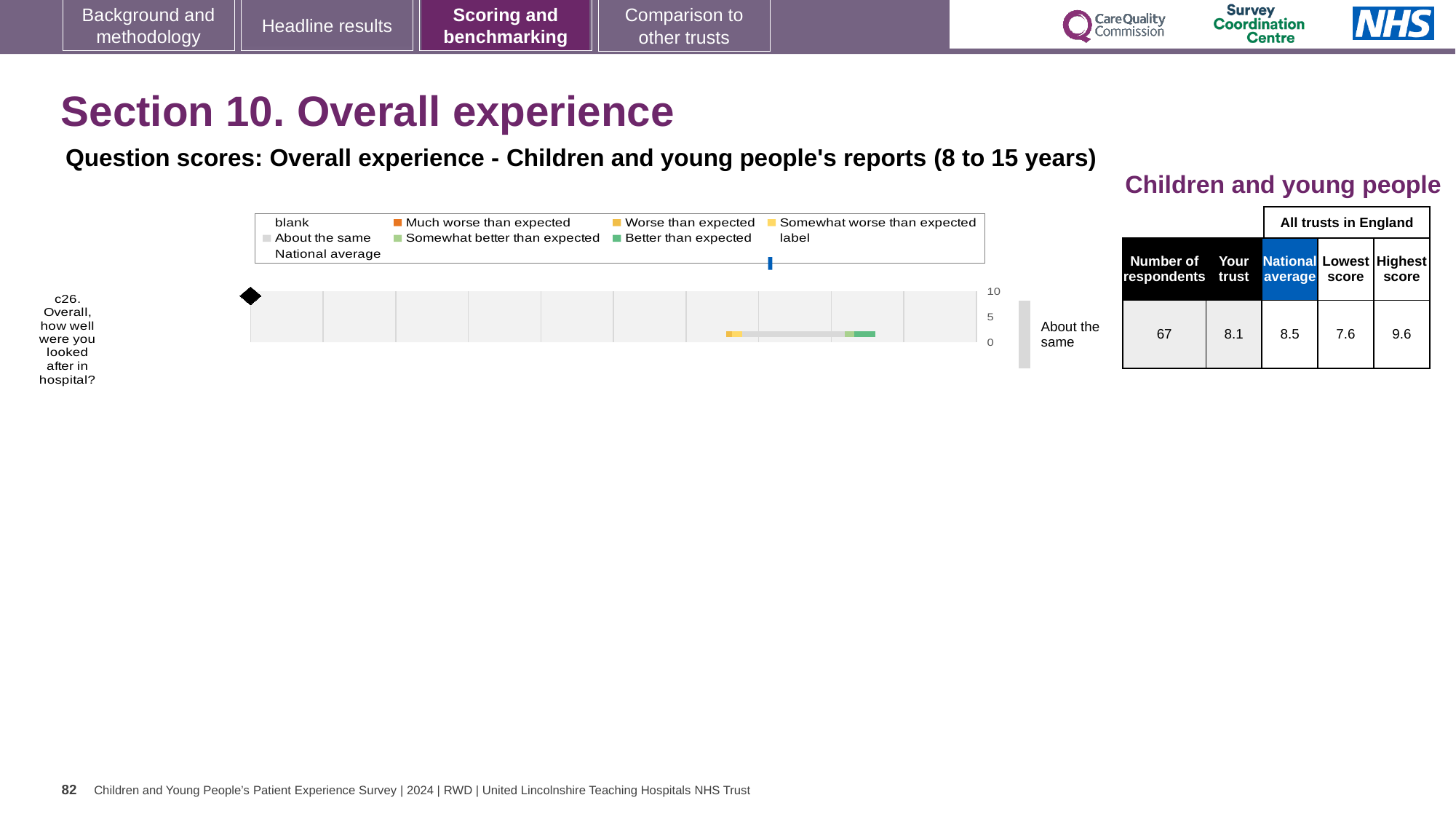
How many respondents answered c26? 67 What is the difference between the highest score (9.6) and the lowest score (7.6) for c26? 2.0 What is the national average score for c26? 8.5 What benchmark category label is shown next to the bar for c26? About the same What is the difference between the national average (8.5) and the trust's score (8.1) for c26? 0.4 What is the lowest score among all trusts in England for c26? 7.6 What is the trust's score for c26 (Overall, how well were you looked after in hospital?)? 8.1 What is the highest score among all trusts in England for c26? 9.6 How many questions (categories) are plotted on the chart? 1 Which is larger for c26, the trust's score or the national average? national average Which question is plotted on the chart? c26. Overall, how well were you looked after in hospital? What kind of chart is shown on the slide? bar chart